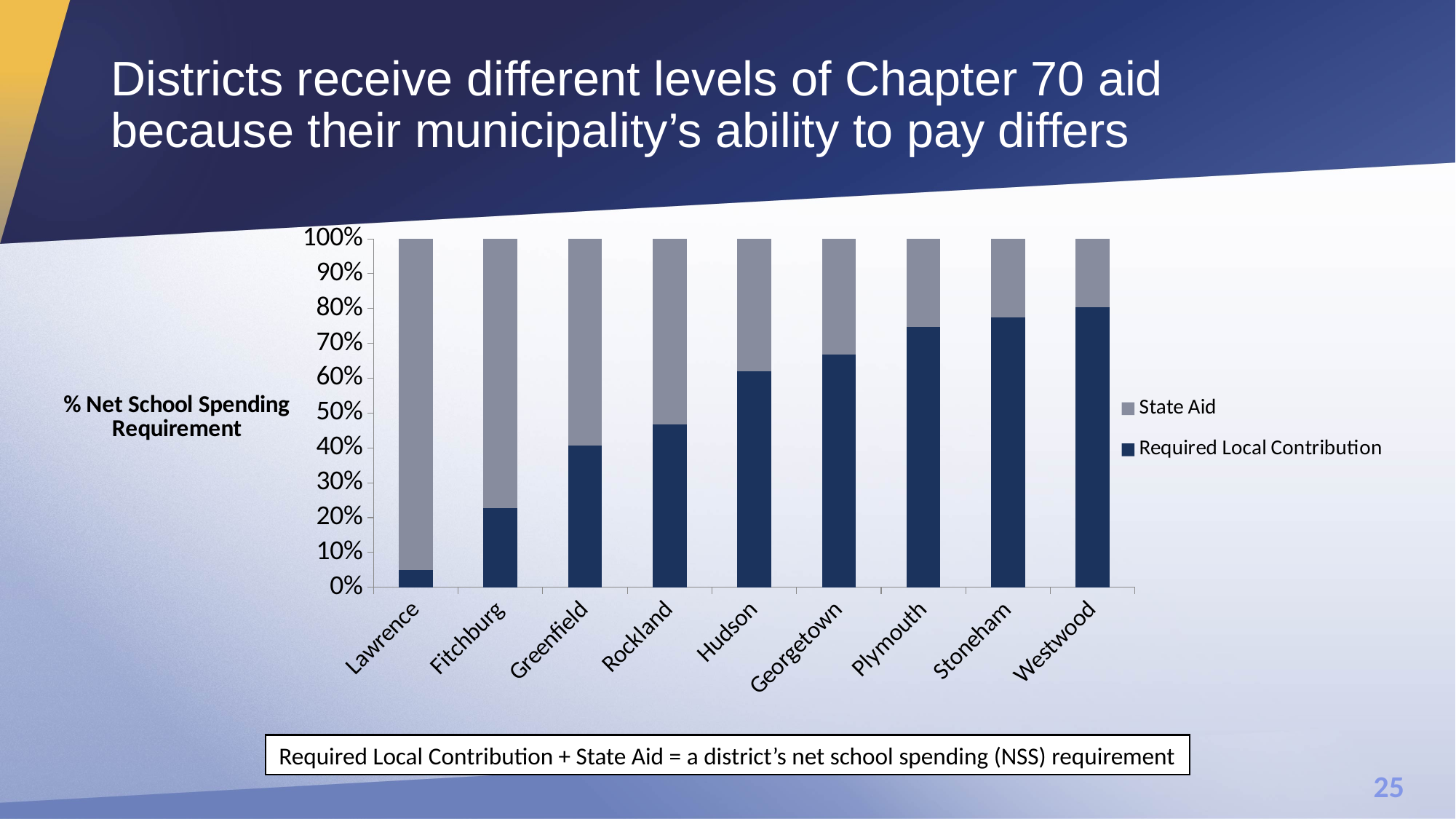
Which district has the lowest Required Local Contribution share? Lawrence Which district receives the largest State Aid share? Lawrence Is the Required Local Contribution for Lawrence greater or less than 10%? less Does the Required Local Contribution share rise or fall moving from Lawrence to Westwood along the x axis? Rise What kind of chart is shown on the slide? Stacked bar chart Is the Required Local Contribution for Hudson greater or less than 60%? greater What is the label on the vertical axis of the chart? % Net School Spending Requirement How many series does the chart's legend list? 2 Is the Required Local Contribution for Fitchburg greater or less than 30%? less Which district has a larger Required Local Contribution share, Rockland or Plymouth? Plymouth Which district has the highest Required Local Contribution share? Westwood How many districts are shown on the x axis of the chart? 9